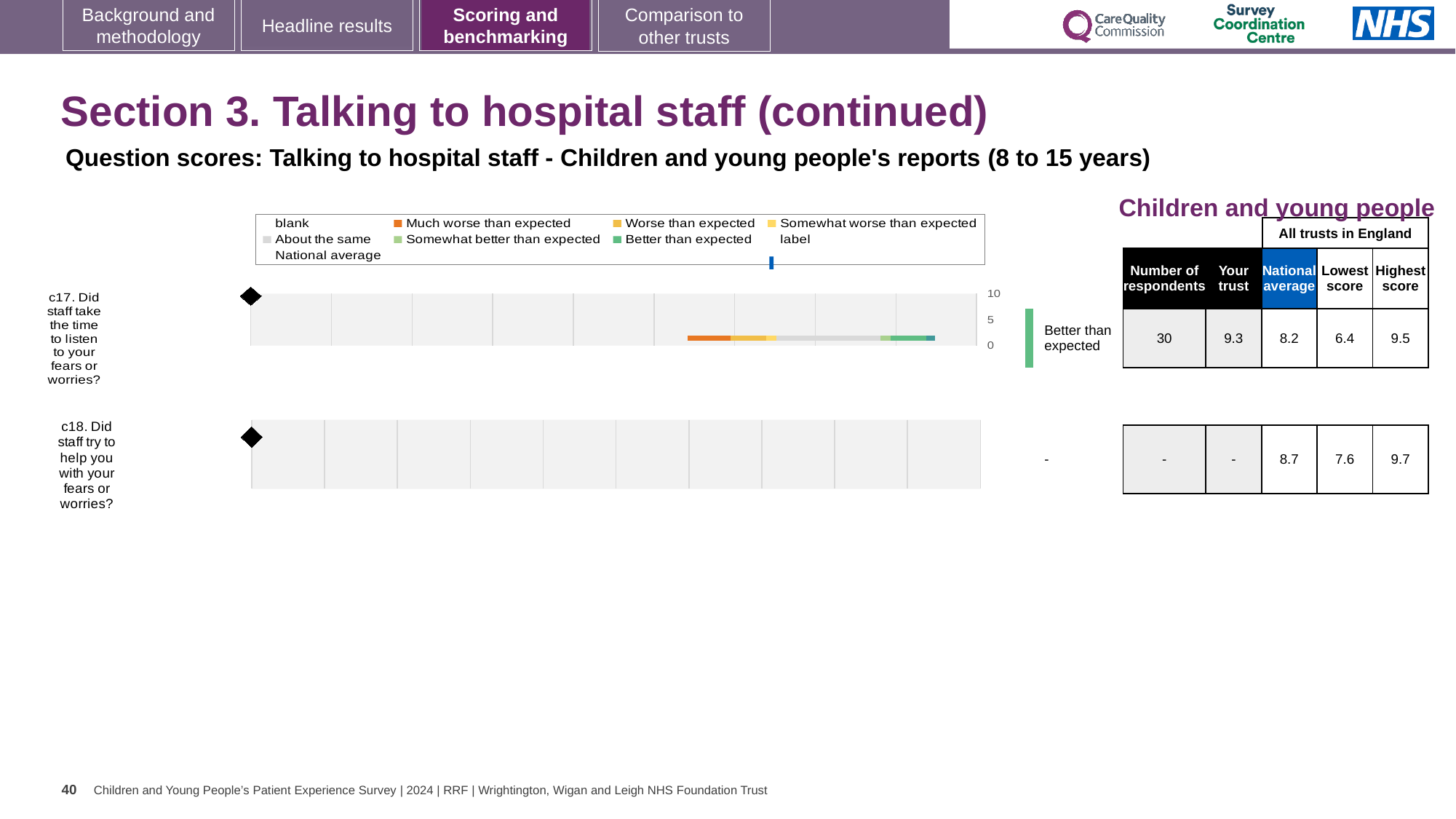
By how much does the trust's score for c17 exceed the national average for c17? 1.1 What is the 'Your trust' score for question c17 (Did staff take the time to listen to your fears or worries?)? 9.3 Which question has the higher 'Highest score' value, c17 or c18? c18 (9.7) What is the highest score across all trusts in England for question c17? 9.5 What is the national average score for question c17? 8.2 What is the lowest score across all trusts in England for question c18 (Did staff try to help you with your fears or worries?)? 7.6 What kind of chart is used to show the question scores? Bar chart What is the difference between the highest and lowest scores for question c18? 2.1 For question c17, which is larger: the trust's score or the national average? Your trust (9.3) How many respondents are recorded for question c17? 30 What benchmark category is shown for the trust's result on question c17? Better than expected How many survey questions are plotted on the chart? 2